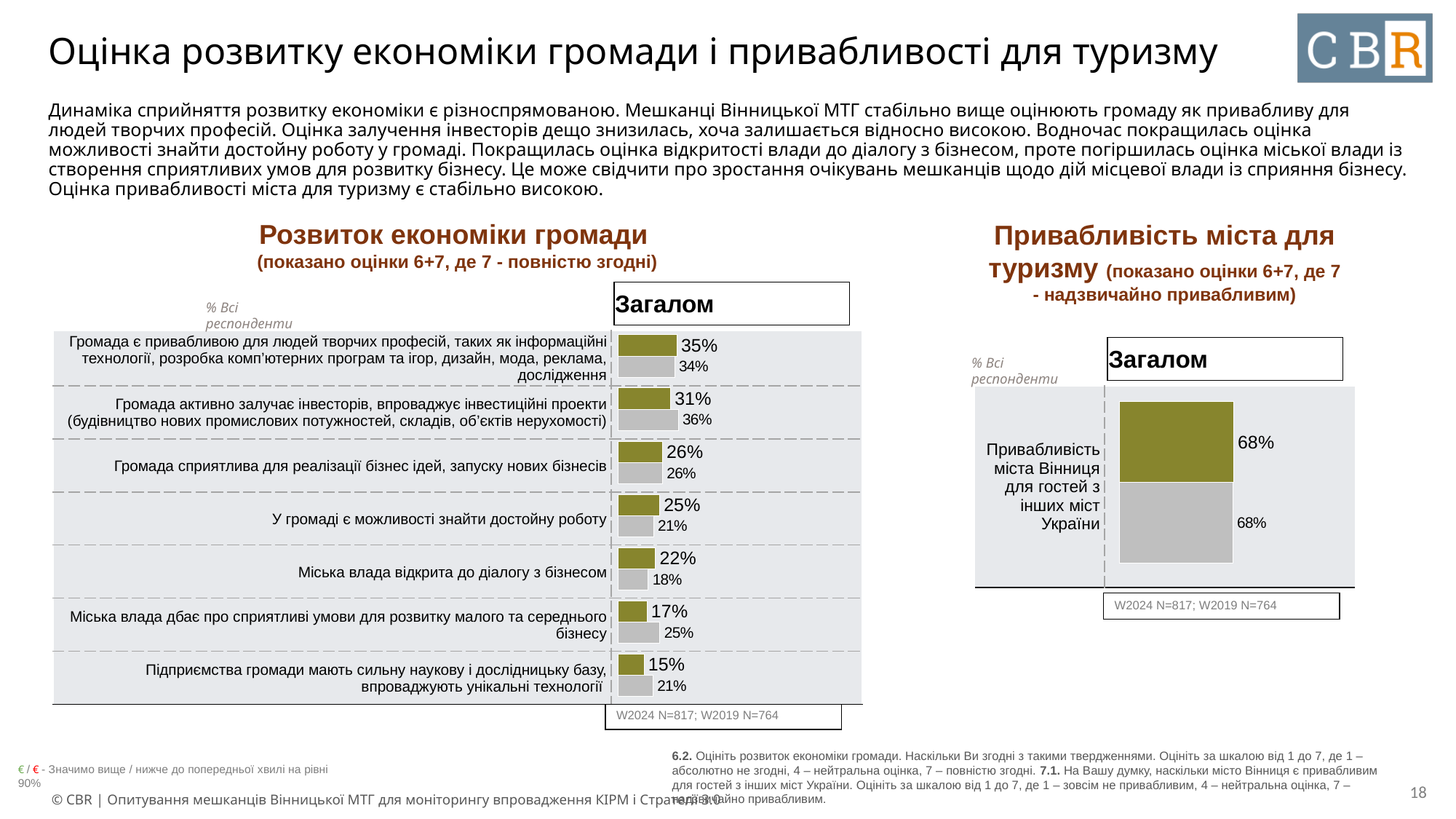
In the chart 'Розвиток економіки громади', which statement has the lowest olive (upper) bar value? Підприємства громади мають сильну наукову і дослідницьку базу, впроваджують унікальні технології In the chart 'Розвиток економіки громади', what is the value of the olive (upper) bar for 'Громада є привабливою для людей творчих професій...'? 35% In the chart 'Розвиток економіки громади', what is the difference between the olive and grey bars for 'Міська влада дбає про сприятливі умови для розвитку малого та середнього бізнесу'? 8 percentage points In the chart 'Привабливість міста для туризму', what is the difference between the olive and grey bars? 0 percentage points In the chart 'Розвиток економіки громади', what is the value of the grey (lower) bar for 'Громада активно залучає інвесторів...'? 36% In the chart 'Розвиток економіки громади', what is the value of the olive (upper) bar for 'У громаді є можливості знайти достойну роботу'? 25% How many statements (categories) are shown in the chart 'Розвиток економіки громади'? 7 In the chart 'Розвиток економіки громади', for 'Міська влада відкрита до діалогу з бізнесом', which bar is larger: the olive (upper) or the grey (lower)? the olive (upper) bar In the chart 'Розвиток економіки громади', which statement has the highest olive (upper) bar value? Громада є привабливою для людей творчих професій, таких як інформаційні технології, розробка комп'ютерних програм та ігор, дизайн, мода, реклама, дослідження What sample sizes are noted below the chart 'Розвиток економіки громади'? W2024 N=817; W2019 N=764 What type of chart is 'Розвиток економіки громади'? bar chart In the chart 'Привабливість міста для туризму', what is the value of the olive (upper) bar for 'Привабливість міста Вінниця для гостей з інших міст України'? 68%